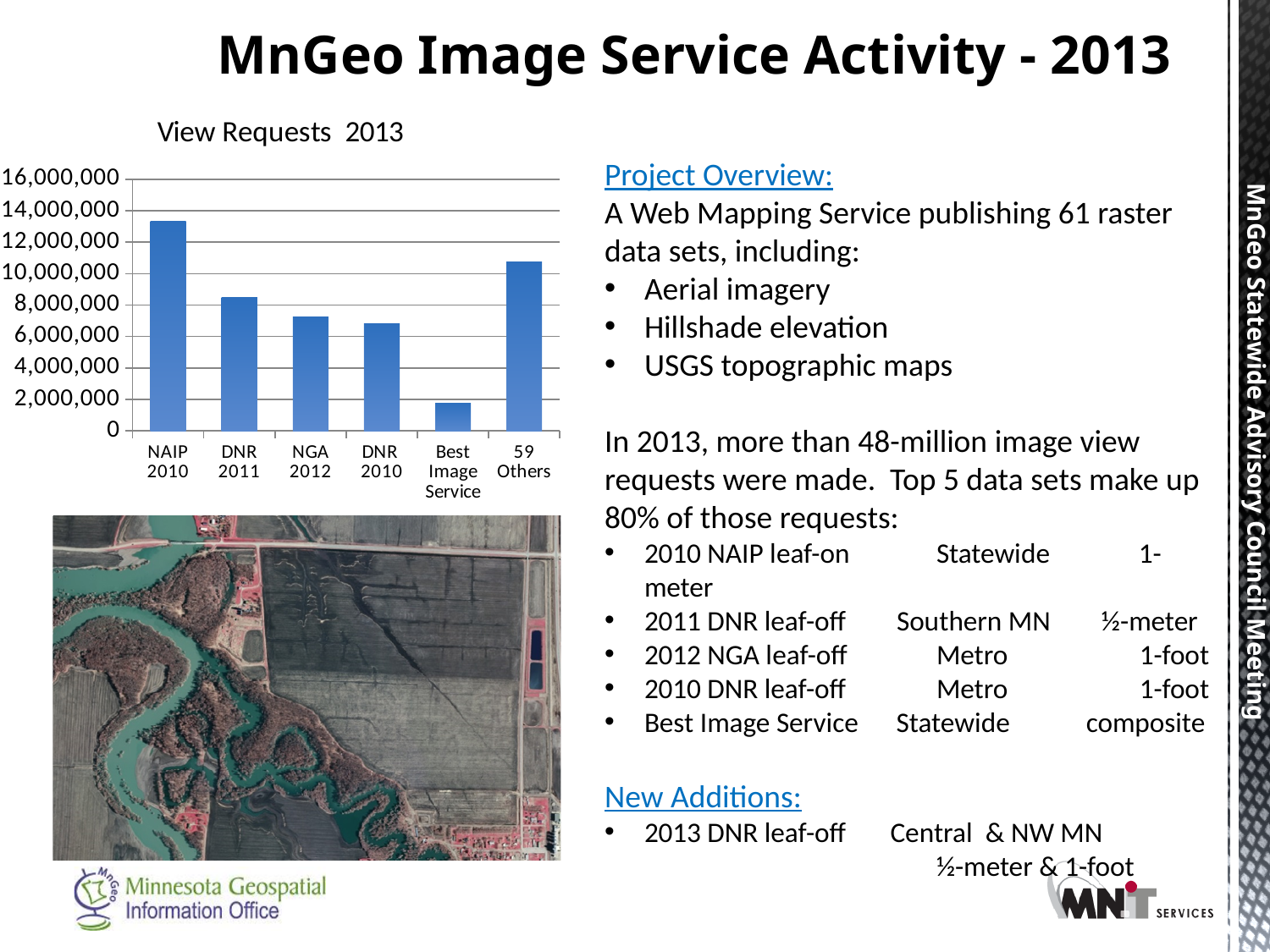
Is the value for 59 Others greater or less than 10,000,000? greater Is the value for DNR 2011 greater or less than 10,000,000? less Which category has the highest number of view requests? NAIP 2010 What kind of chart is shown on the slide? bar chart Which is larger, the value for NGA 2012 or the value for Best Image Service? NGA 2012 Which is larger, the value for DNR 2011 or the value for 59 Others? 59 Others Which category has the lowest number of view requests? Best Image Service How many categories are shown on the x axis of the chart? 6 Do the values rise or fall from NAIP 2010 through Best Image Service along the x axis? fall What is the title of the chart? View Requests 2013 Is the value for Best Image Service greater or less than 2,000,000? less